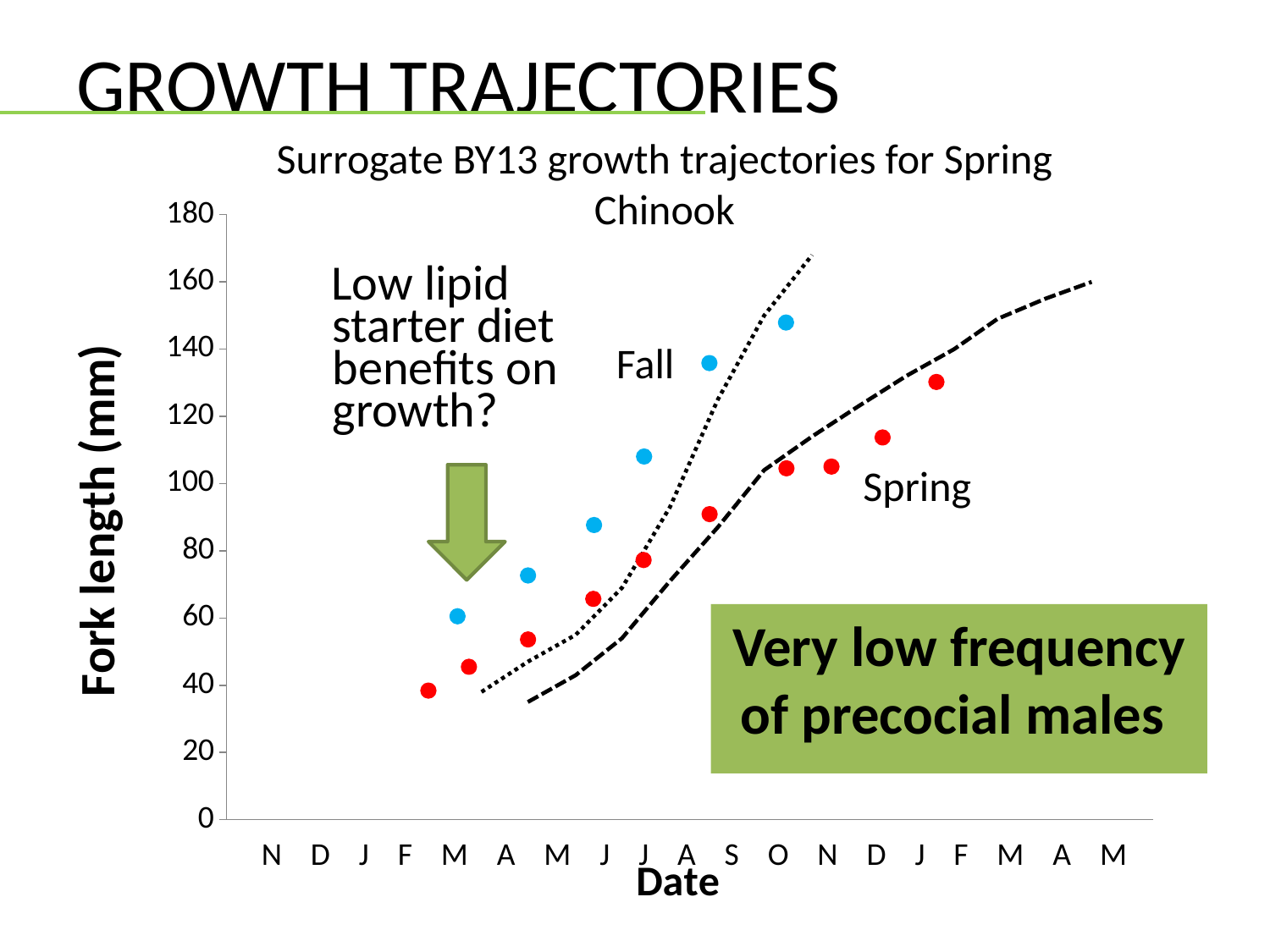
Do the fork length values rise or fall over time along the x axis? rise Is the highest Fall point greater or less than 140 mm? greater What kind of chart is shown on the slide? scatter chart Is the highest Spring point greater or less than 140 mm? less What is the label on the vertical axis of the chart? Fork length (mm) Which series is plotted with blue points, Fall or Spring? Fall Is the lowest Fall point greater or less than 40 mm? greater What is the title of the chart? Surrogate BY13 growth trajectories for Spring Chinook Which series reaches the higher fork length, Fall or Spring? Fall